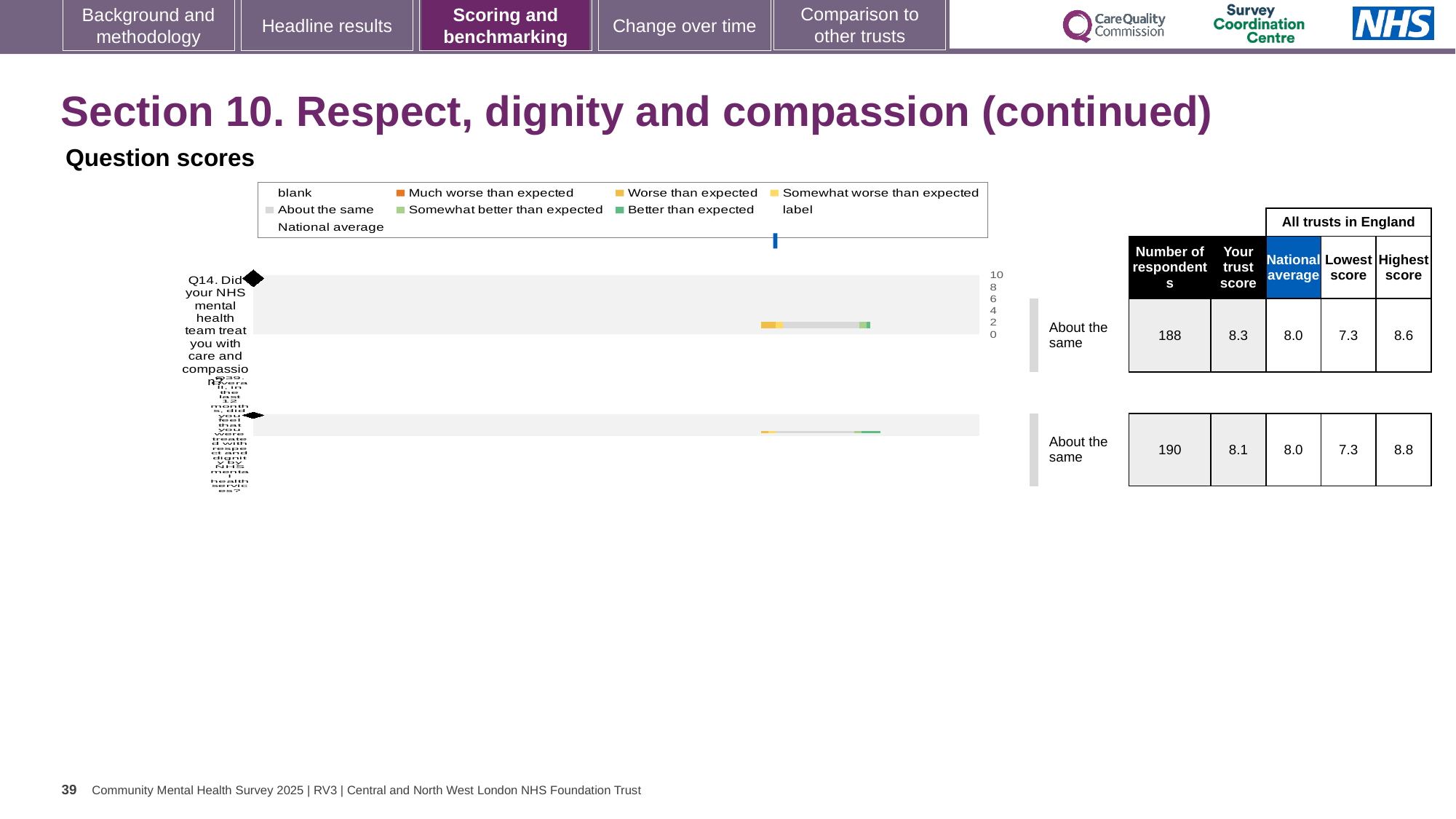
Which legend entry is shown in orange in the question scores chart? Much worse than expected What is the difference between the trust's score and the national average for Q14? 0.3 What is the difference between the highest and lowest scores among all trusts in England for Q14? 1.3 What is the trust's score for the second question (Q39)? 8.1 What is the trust's score for Q14 (treated with care and compassion)? 8.3 What kind of chart is used to show the question scores on this slide? bar chart How many respondents answered Q14? 188 What is the highest value shown on the chart's score axis? 10 Which is larger for Q14: the trust's score or the national average? the trust's score What is the national average score for Q14? 8.0 How many questions are plotted in the question scores chart? 2 What is the highest score among all trusts in England for the second question (Q39)? 8.8